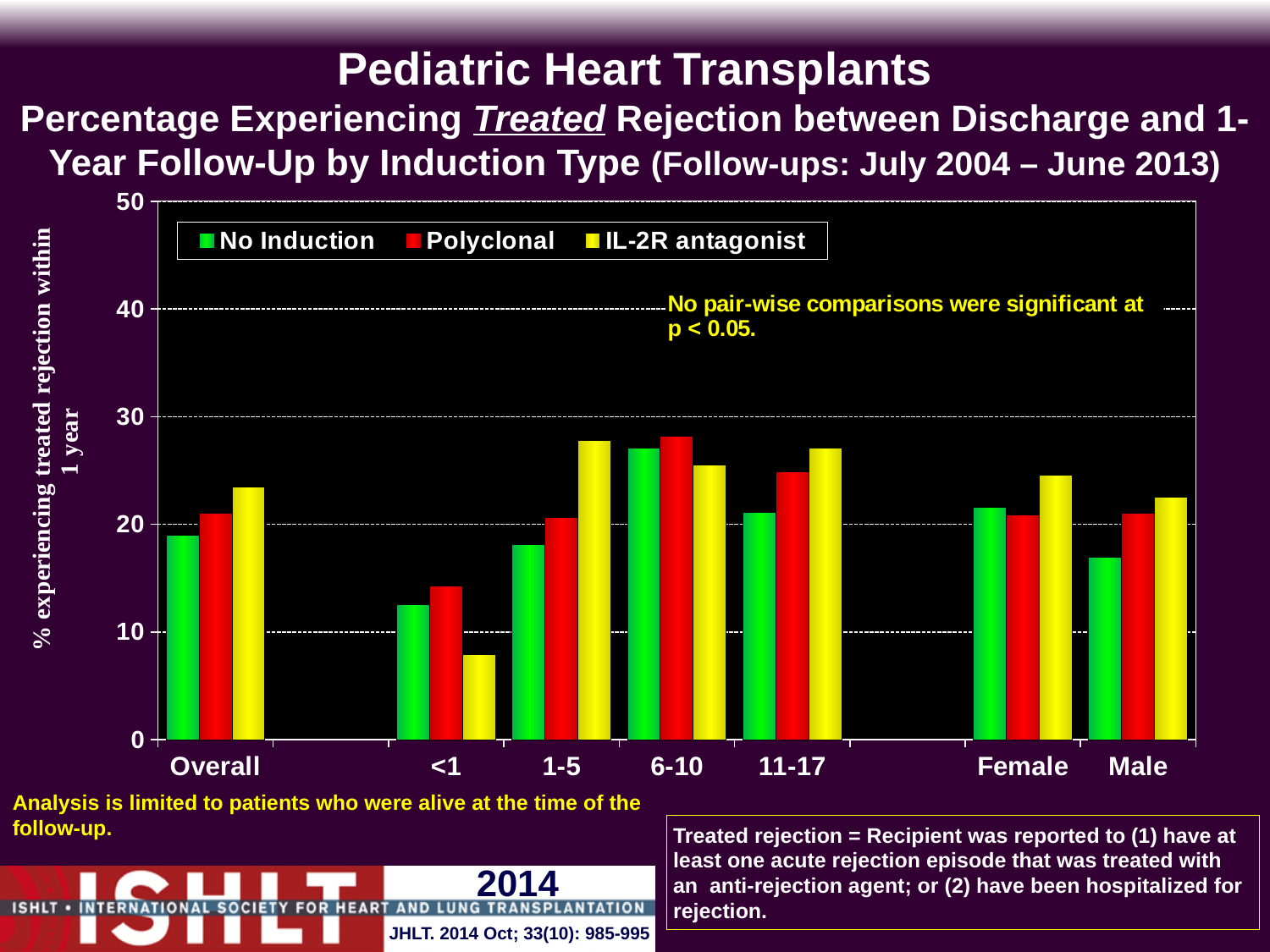
How many categories are shown along the x axis? 7 How many series does the legend list? 3 What kind of chart is shown on the slide? bar chart Is the No Induction value for Male greater or less than 20? less Is the IL-2R antagonist value for the <1 age group greater or less than 10? less What are the three induction types listed in the legend? No Induction, Polyclonal, IL-2R antagonist Is the IL-2R antagonist value for the 1-5 age group greater or less than 20? greater Within the <1 age group, which induction type has the lowest value? IL-2R antagonist Which category has the lowest IL-2R antagonist value? <1 For the <1 age group, which is larger: the Polyclonal value or the IL-2R antagonist value? Polyclonal For Male, which is larger: the No Induction value or the IL-2R antagonist value? IL-2R antagonist